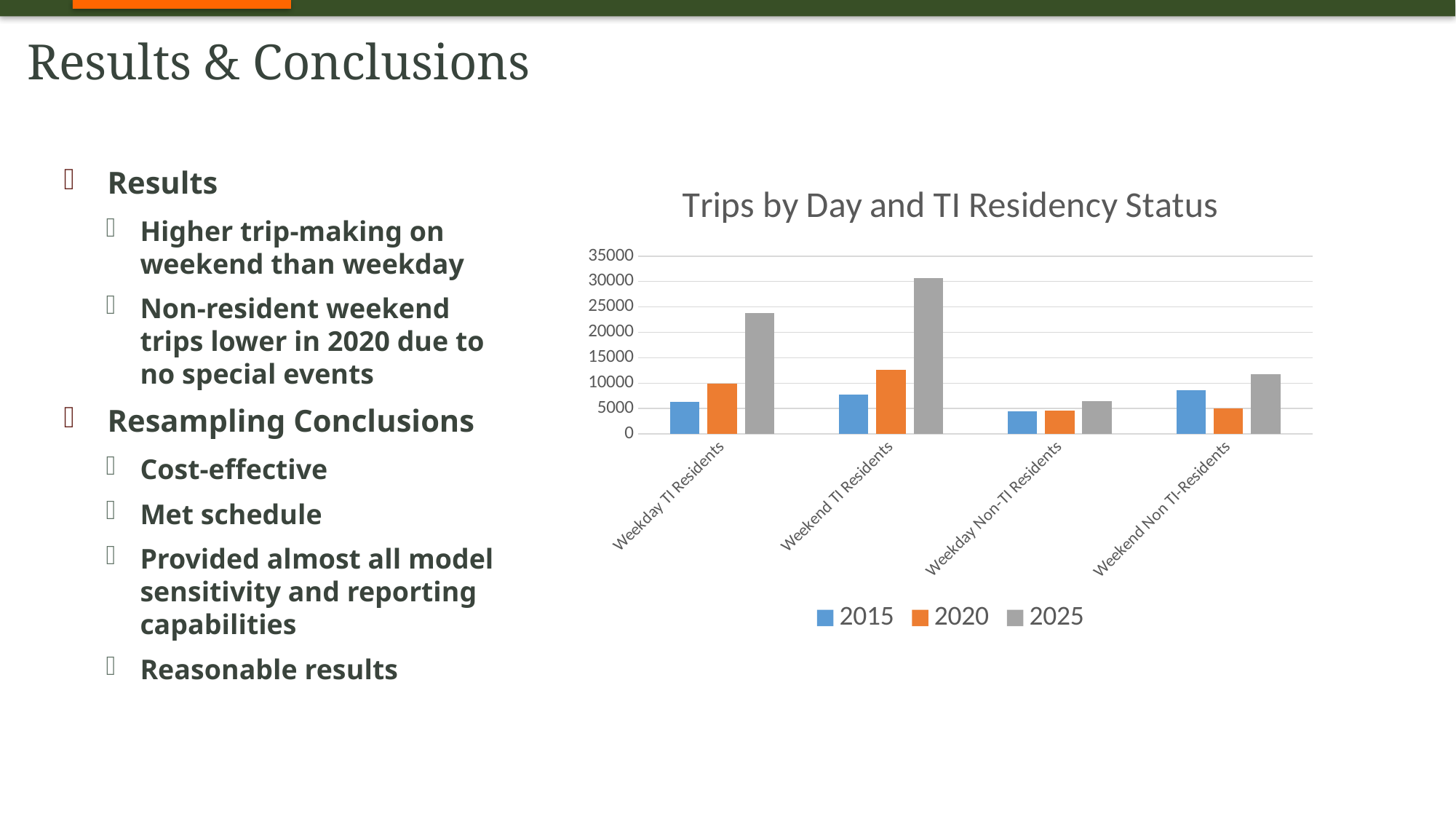
Is the 2025 value for Weekday TI Residents greater or less than 20000? greater Is the 2025 value for Weekend TI Residents greater or less than 25000? greater What type of chart is shown on the slide? bar chart Which category has the highest 2025 value? Weekend TI Residents Is the 2025 value for Weekday Non-TI Residents greater or less than 10000? less Which category has the lowest 2015 value? Weekday Non-TI Residents Which series is shown in orange in the chart? 2020 How many series does the chart's legend list? 3 What is the title of the chart? Trips by Day and TI Residency Status How many categories are shown on the x axis of the chart? 4 For Weekend Non TI-Residents, which is larger: the 2015 value or the 2020 value? 2015